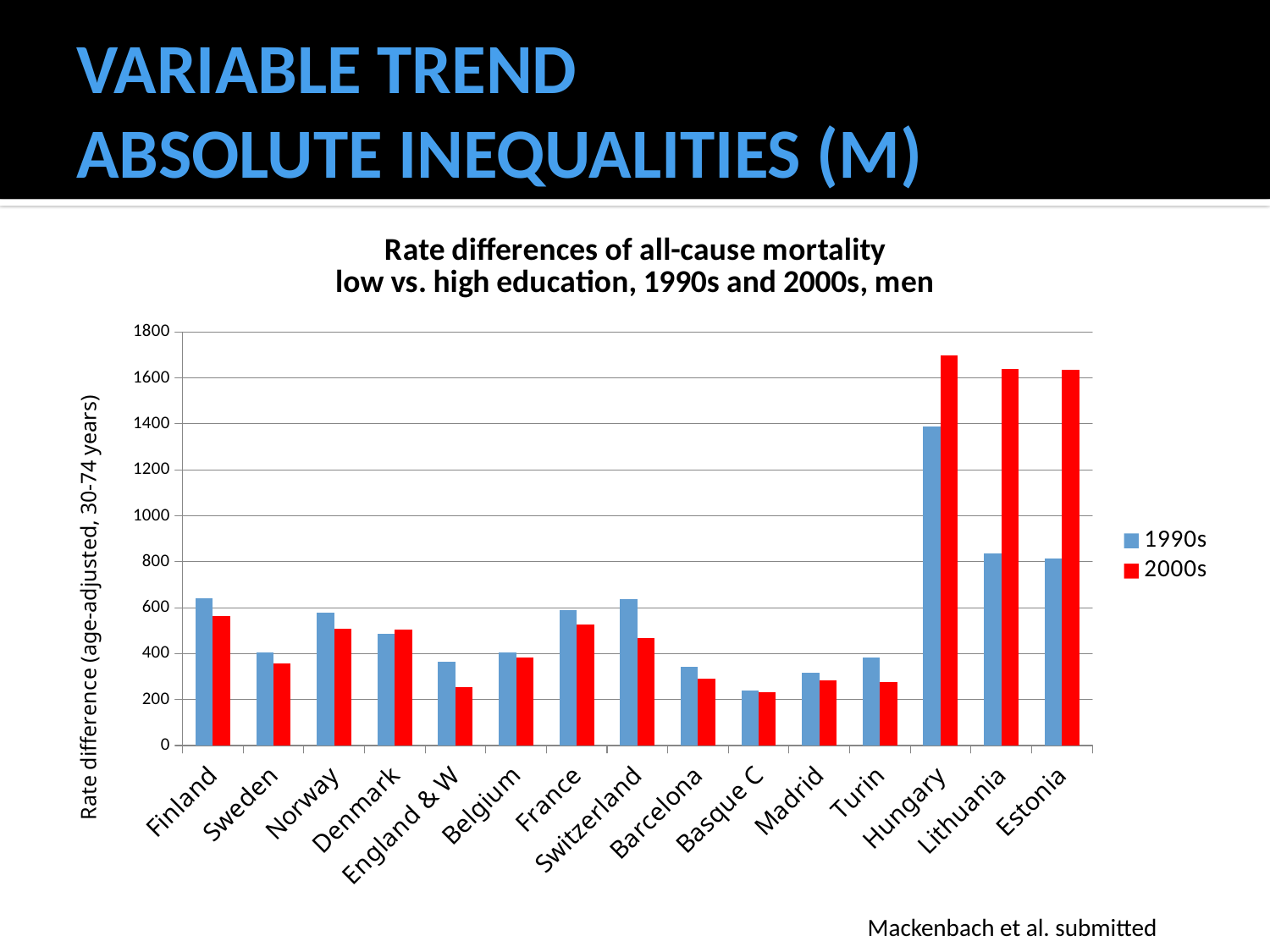
What kind of chart is shown on the slide? bar chart Is the 2000s value for Estonia greater or less than 1400? greater For Hungary, which is larger: the 1990s value or the 2000s value? 2000s Is the 2000s value for Sweden greater or less than 400? less Is the 2000s value for England & W greater or less than 400? less Which country has the highest rate difference for the 2000s? Hungary How many series does the legend list? 2 For Switzerland, which is larger: the 1990s value or the 2000s value? 1990s How many countries or regions are shown on the x axis? 15 Which colour represents the 2000s series in the legend? red Which country or region has the lowest rate difference for the 1990s? Basque C